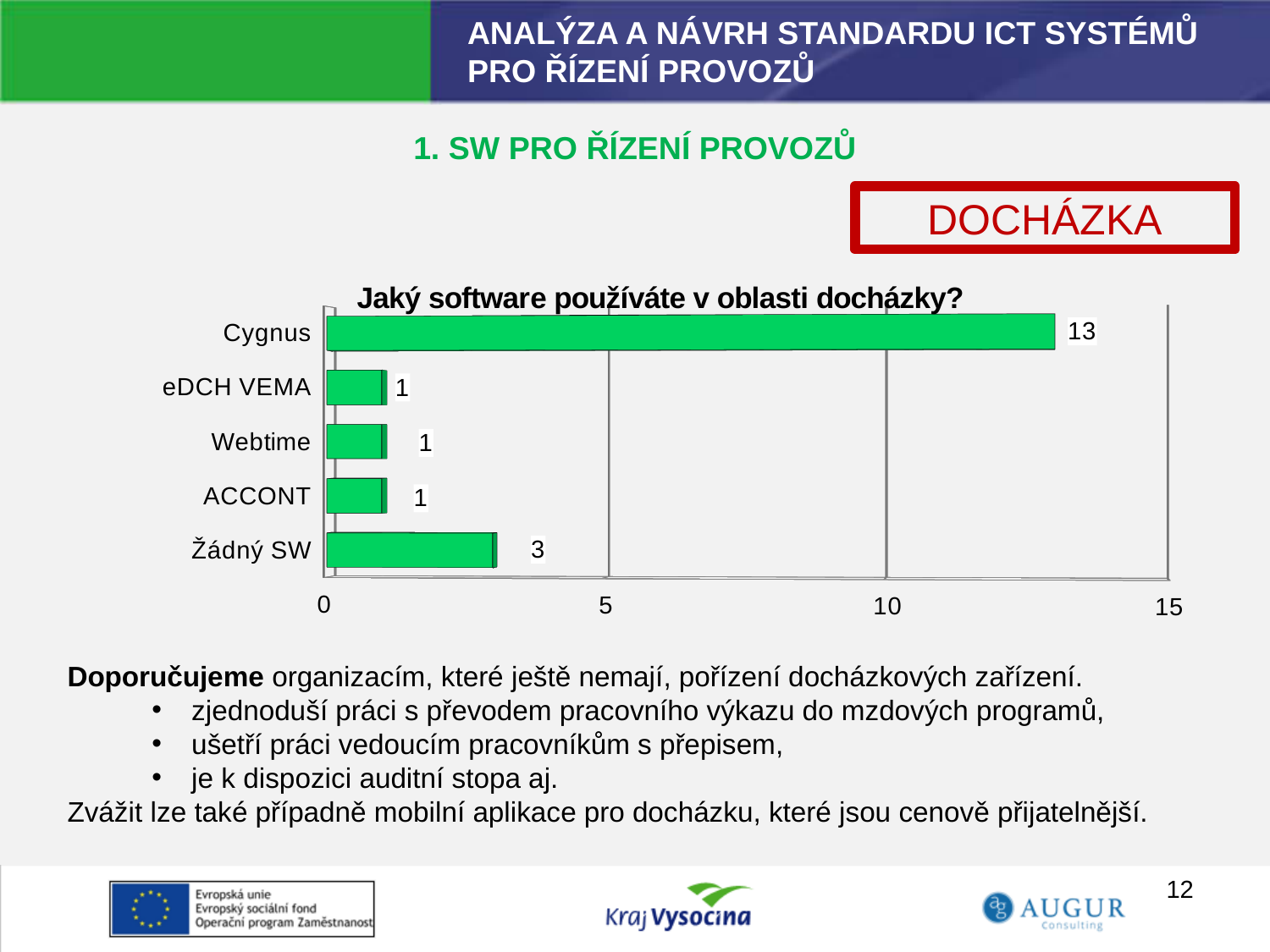
What kind of chart is shown on the slide? bar chart Is the value for Cygnus greater or less than 10? greater What is the title of the chart? Jaký software používáte v oblasti docházky? What is the difference between the values for Cygnus and Žádný SW? 10 What is the value for Žádný SW? 3 What is the difference between the values for Žádný SW and Webtime? 2 How many categories are shown in the chart? 5 What is the value for eDCH VEMA? 1 Which is larger, the value for Žádný SW or the value for ACCONT? Žádný SW What is the value for Cygnus? 13 Which category has the highest value? Cygnus What is the highest value shown on the x axis? 15